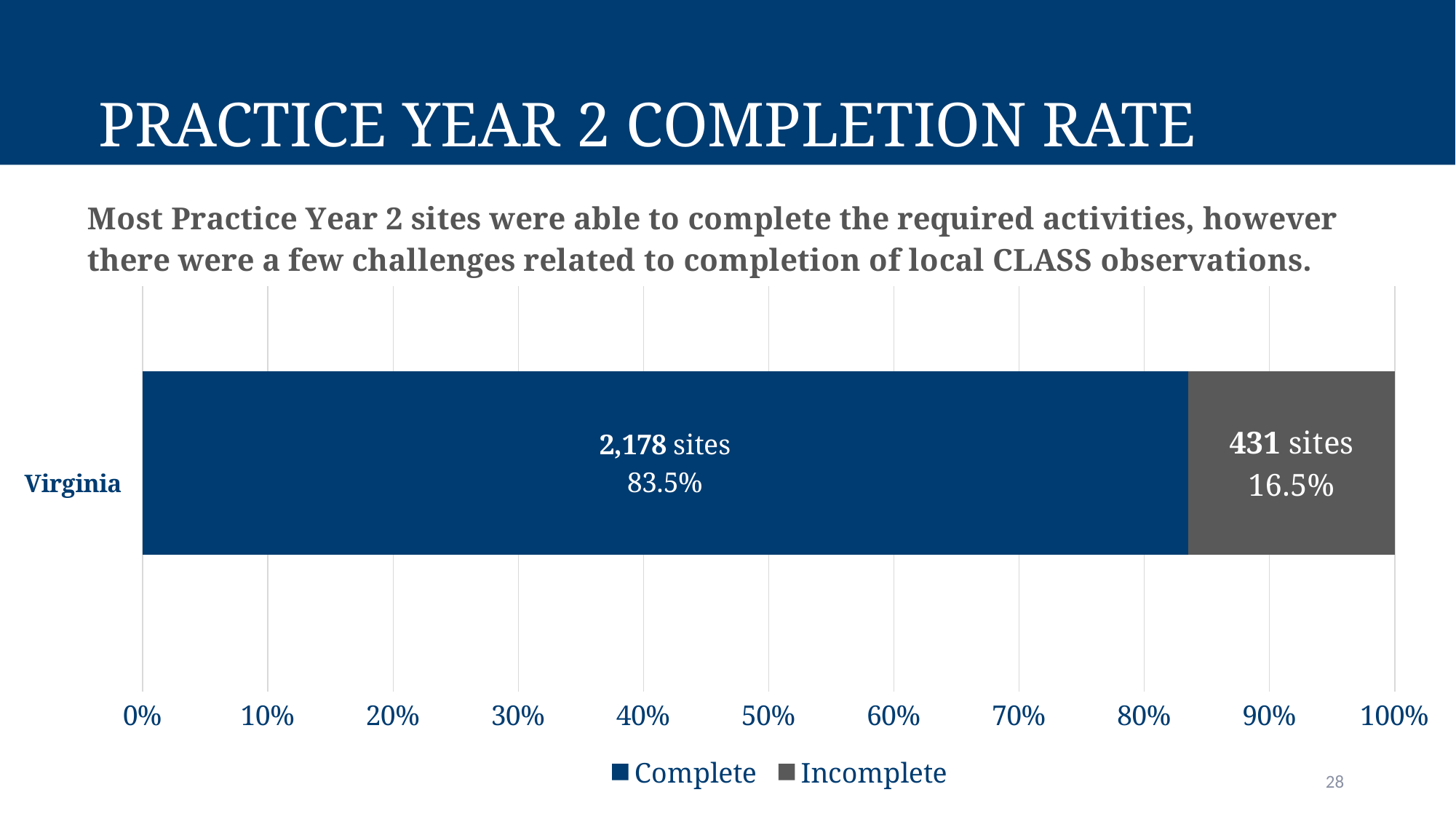
How many Virginia sites are labelled as Complete? 2,178 sites What percentage of Virginia sites are shown as Complete? 83.5% Which series has the larger share for Virginia, Complete or Incomplete? Complete Is the Incomplete share for Virginia greater or less than 20%? less What kind of chart is shown on the slide? Stacked bar chart How many series does the legend list? 2 What colour represents the Incomplete series in the chart? Grey What is the total number of sites for Virginia, combining Complete and Incomplete? 2,609 sites What percentage of Virginia sites are shown as Incomplete? 16.5% What is the difference in percentage points between the Complete and Incomplete shares for Virginia? 67 percentage points Is the Complete share for Virginia greater or less than 80%? greater How many Virginia sites are labelled as Incomplete? 431 sites